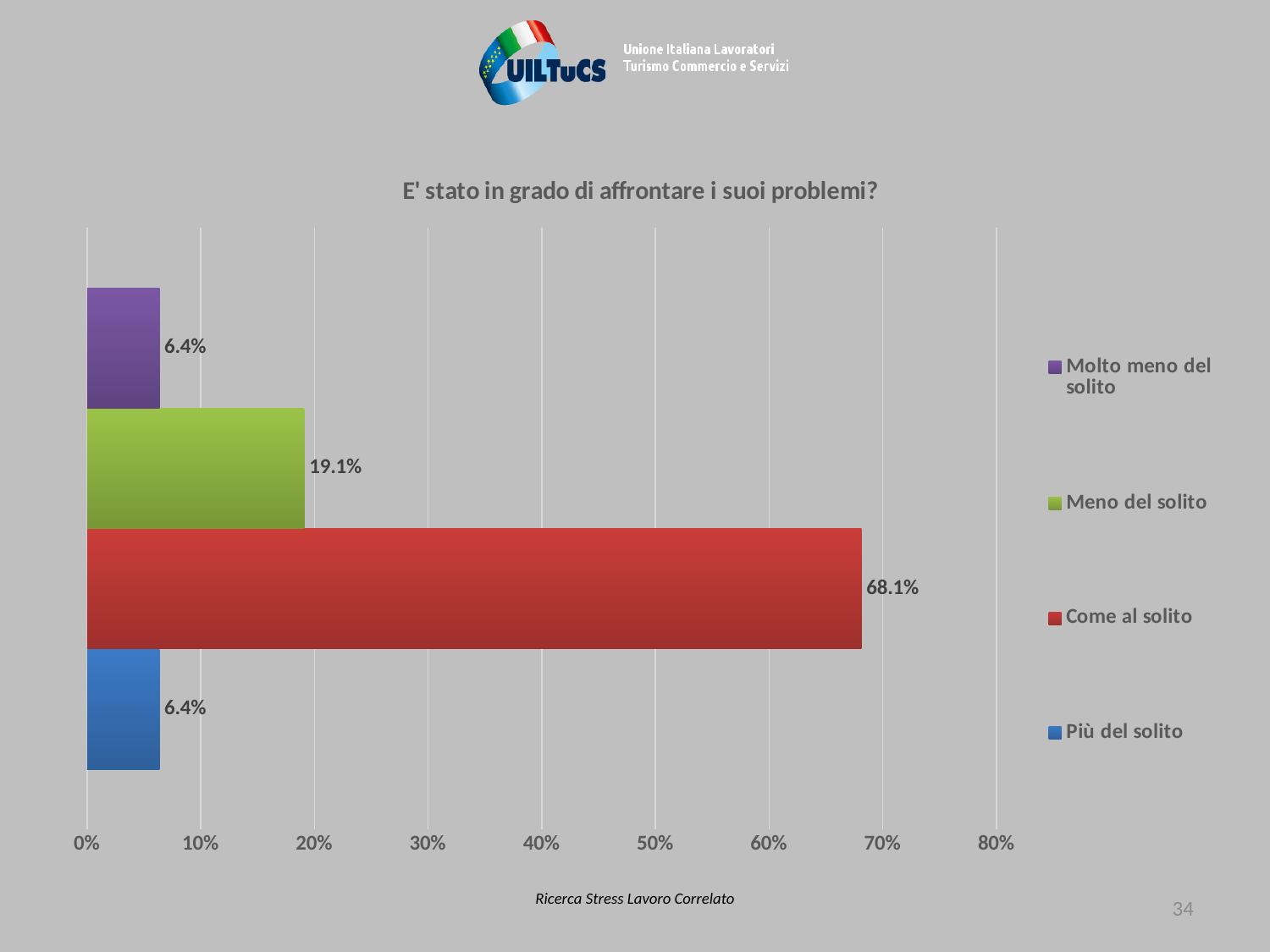
What is the difference between the values for "Come al solito" and "Meno del solito"? 49.0% Which category has the highest value? Come al solito Is the value for "Come al solito" greater or less than 60%? greater What is the value for "Meno del solito"? 19.1% What is the value for "Come al solito"? 68.1% How many series does the legend list? 4 What kind of chart is shown on the slide? Bar chart What is the title of the chart? E' stato in grado di affrontare i suoi problemi? What is the value for "Molto meno del solito"? 6.4% Which is larger, the value for "Meno del solito" or the value for "Molto meno del solito"? Meno del solito What is the difference between the values for "Meno del solito" and "Più del solito"? 12.7% What is the value for "Più del solito"? 6.4%